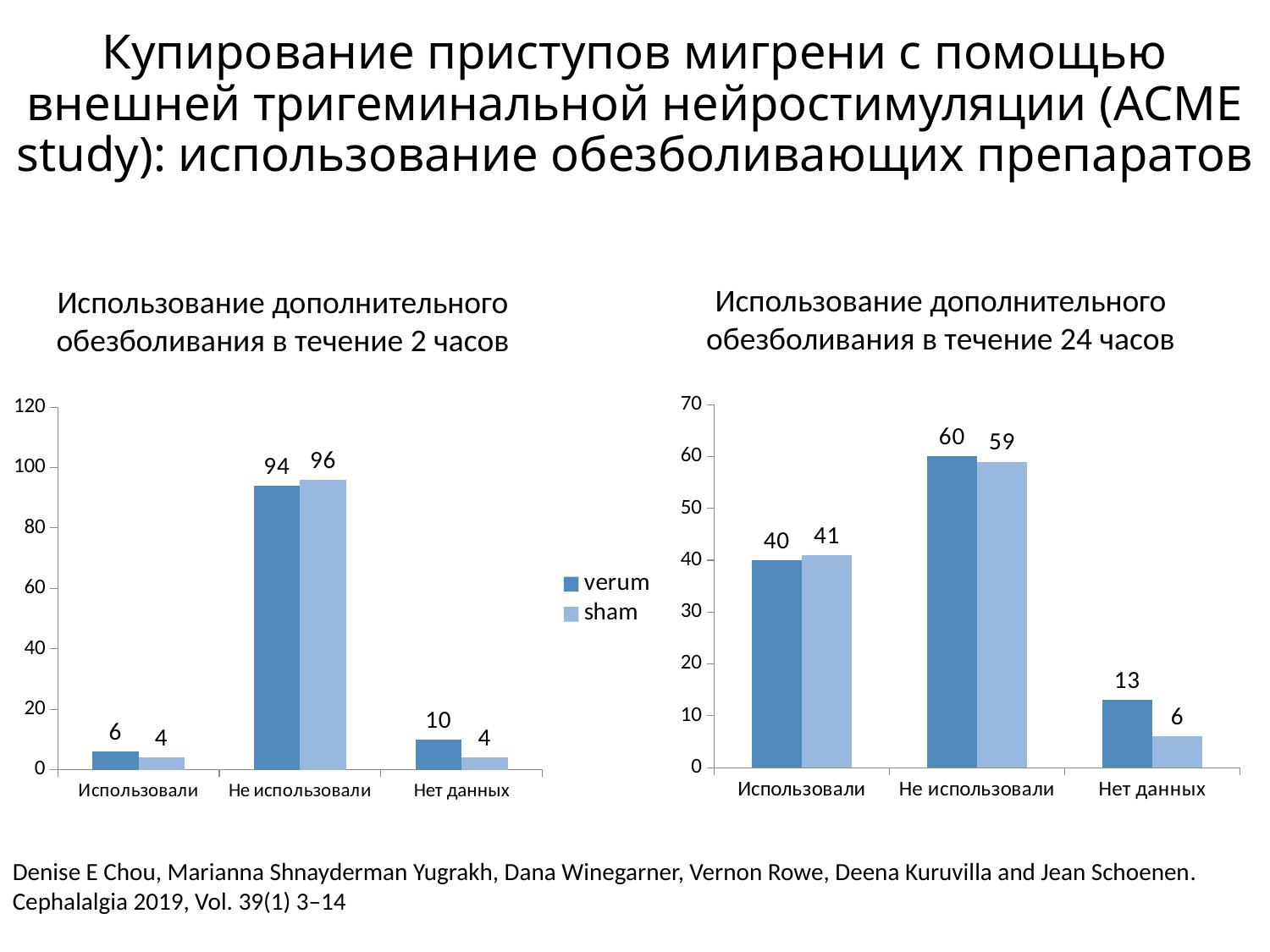
In the left chart (2 hours), which category has the lowest sham value? Использовали and Нет данных (both 4) In the right chart (24 hours), what is the difference between the verum and sham values for 'Нет данных'? 7 In the right chart (24 hours), what is the verum value for 'Нет данных'? 13 How many categories are shown on the x axis of the left chart (2 hours)? 3 In the right chart (24 hours), which is larger for 'Не использовали': verum or sham? verum In the right chart (24 hours), which category has the highest verum value? Не использовали In the left chart (2 hours), what is the difference between the verum and sham values for 'Нет данных'? 6 In the left chart (2 hours), what is the sham value for 'Нет данных'? 4 How many series does the legend list? 2 In the left chart (2 hours), what is the verum value for 'Не использовали'? 94 What type of chart is the right chart (24 hours)? bar chart In the right chart (24 hours), what is the sham value for 'Использовали'? 41